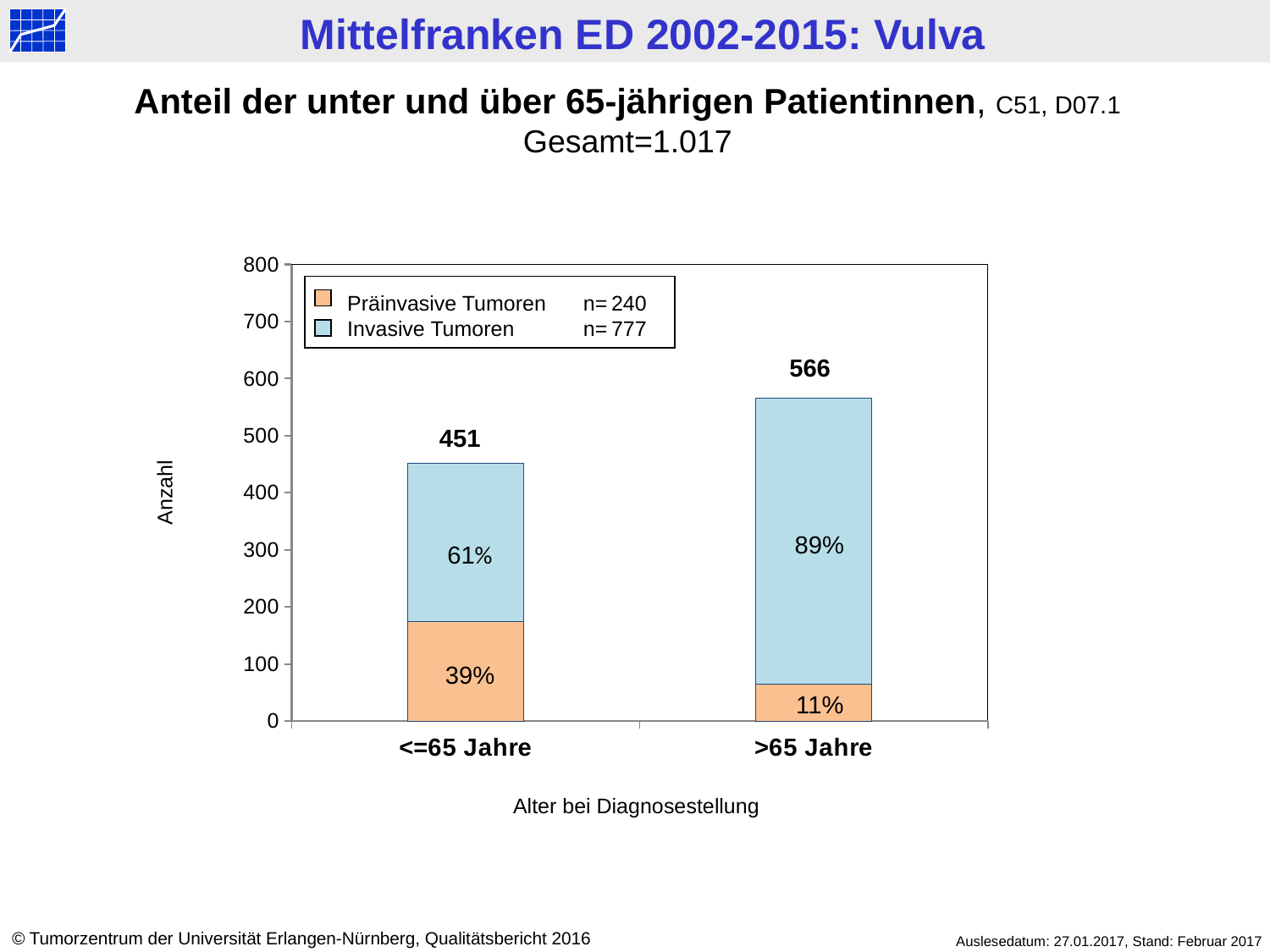
What is the label of the y axis? Anzahl What percentage of the >65 Jahre bar is Präinvasive Tumoren? 11% What percentage of the <=65 Jahre bar is Invasive Tumoren? 61% Is the total for the <=65 Jahre bar greater or less than 500? less What type of chart is shown on the slide? stacked bar chart Which age category has the higher total number of patients? >65 Jahre How many age categories are shown on the x axis? 2 What is the total number of patients in the >65 Jahre bar? 566 What is the total number of patients in the <=65 Jahre bar? 451 According to the legend, what is the n for Invasive Tumoren? n= 777 How many series does the legend list? 2 What is the difference between the totals of the >65 Jahre and <=65 Jahre bars? 115